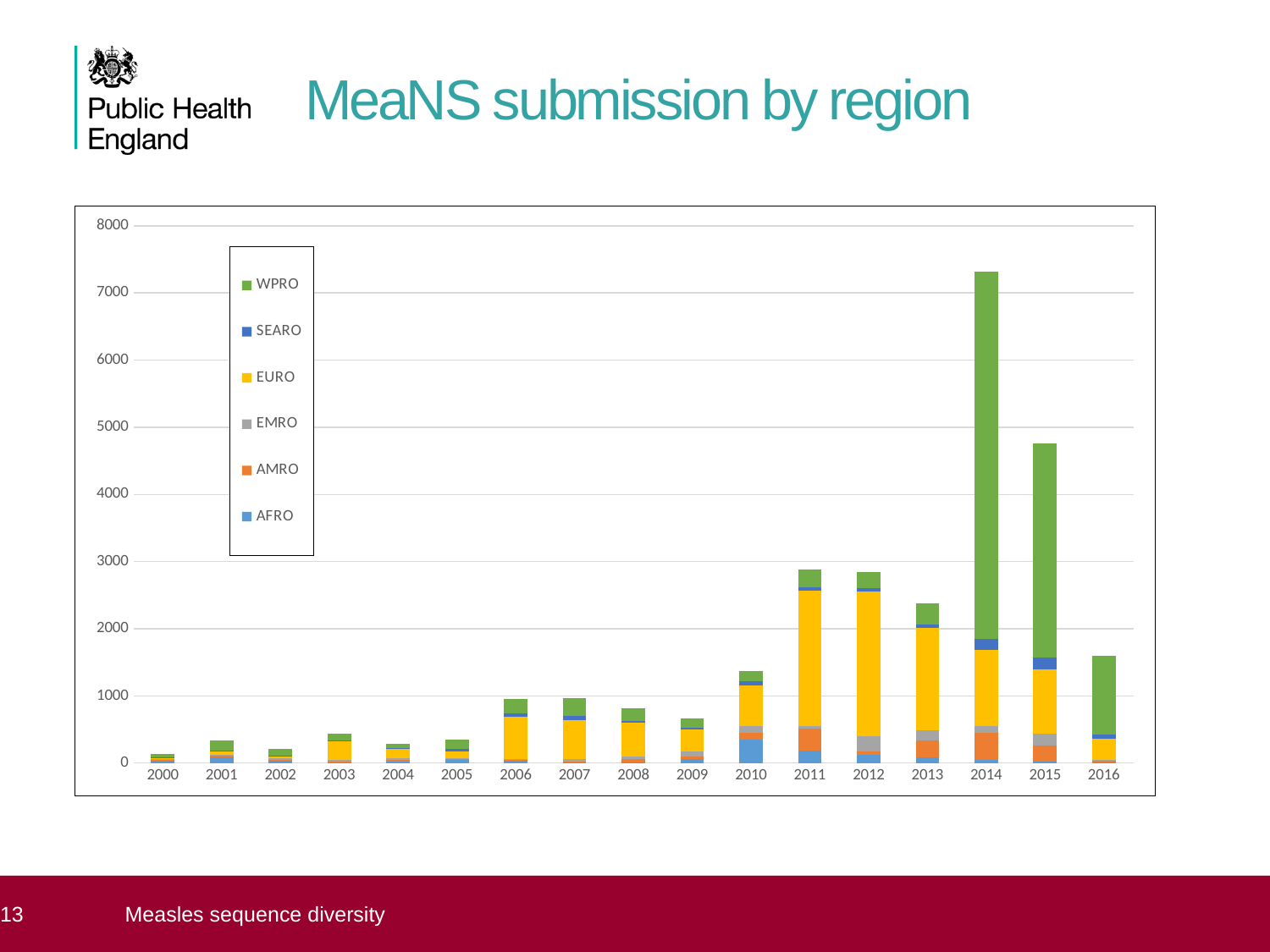
How many series does the chart's legend list? 6 Which year has the larger total, 2014 or 2015? 2014 Which year has the tallest bar in the chart? 2014 How many years are shown along the x axis of the chart? 17 What kind of chart is shown on the slide? stacked bar chart Is the total for 2016 greater or less than 1000? greater Is the total for 2014 greater or less than 7000? greater Is the total for 2009 greater or less than 1000? less Which year has the shortest bar in the chart? 2000 Do the bar totals rise or fall from 2014 to 2016? fall What is the title of the chart on the slide? MeaNS submission by region